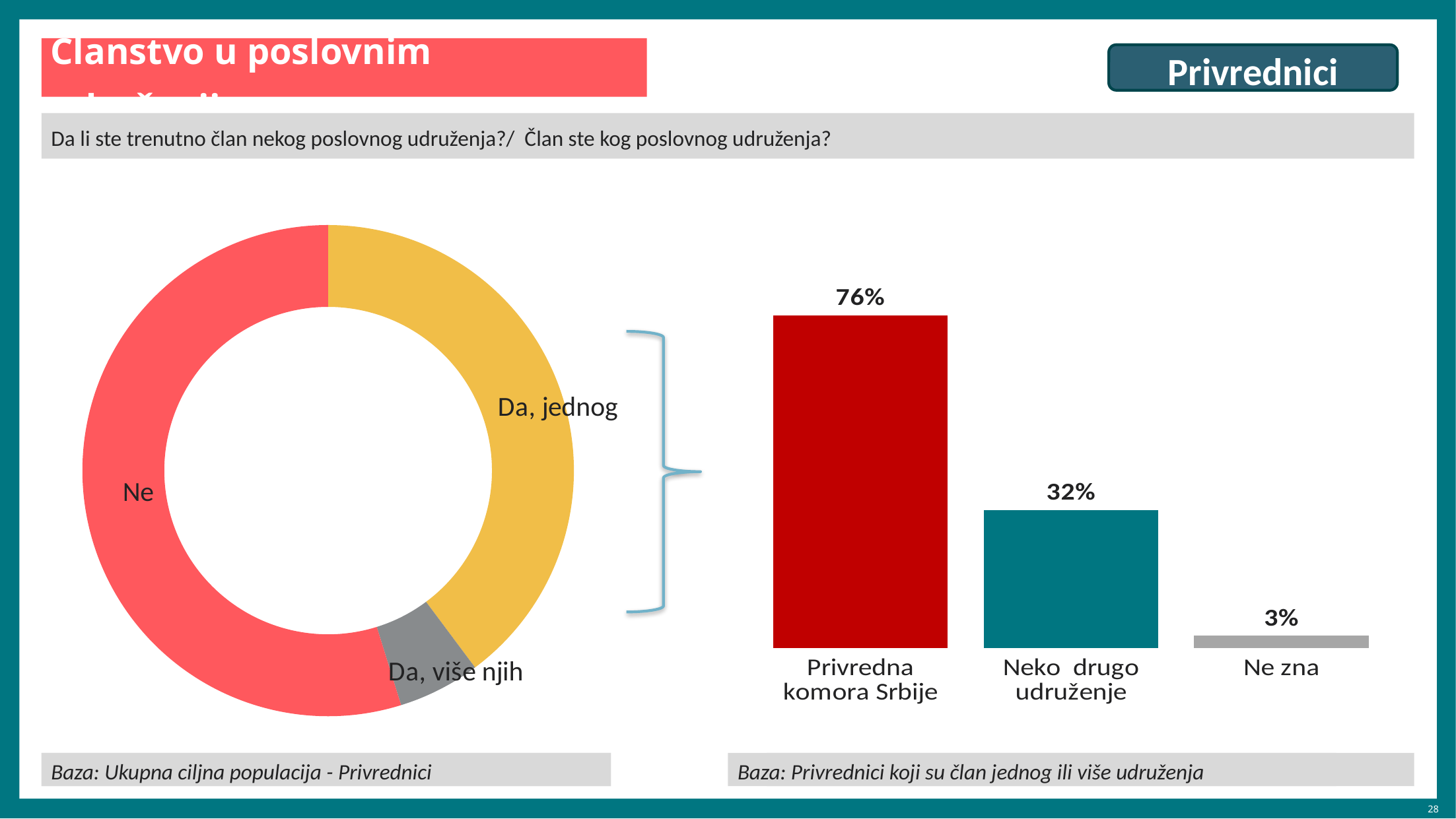
How many categories are shown on the bar chart on the right? 3 On the bar chart on the right, what is the value for Privredna komora Srbije? 76% What kind of chart is the chart on the right side of the slide? Bar chart On the bar chart on the right, which category has the lowest value? Ne zna On the bar chart on the right, what is the value for Ne zna? 3% What kind of chart is the chart on the left side of the slide? Donut chart On the bar chart on the right, what is the difference between the values for Privredna komora Srbije and Neko drugo udruženje? 44 percentage points On the bar chart on the right, which is larger: Neko drugo udruženje or Ne zna? Neko drugo udruženje How many categories are shown on the donut chart on the left? 3 On the donut chart on the left, which category has the smallest slice? Da, više njih On the bar chart on the right, which category has the highest value? Privredna komora Srbije On the bar chart on the right, what is the value for Neko drugo udruženje? 32%